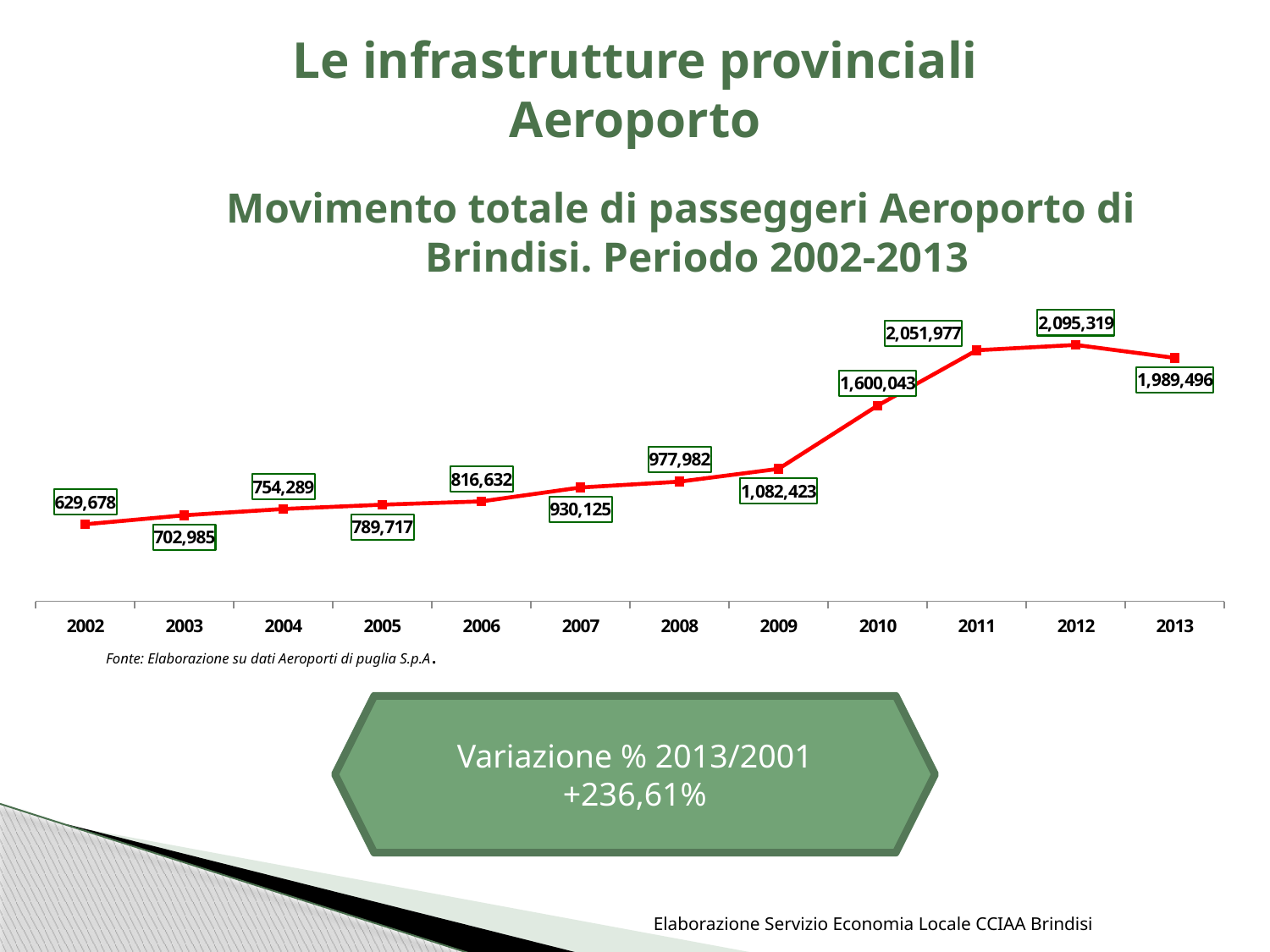
What is the value shown for 2013? 1,989,496 Do the values generally rise or fall from 2002 to 2012? Rise Which year has the lowest passenger movement? 2002 What is the total passenger movement at Brindisi airport in 2002? 629,678 What is the value shown for 2010? 1,600,043 By how much did the value increase from 2009 to 2010? 517,620 Which year has a larger value, 2011 or 2013? 2011 What is the difference between the values for 2012 and 2013? 105,823 What is the title of the chart? Movimento totale di passeggeri Aeroporto di Brindisi. Periodo 2002-2013 What kind of chart is shown on the slide? Line chart Which year has the highest passenger movement? 2012 How many years are plotted on the chart? 12